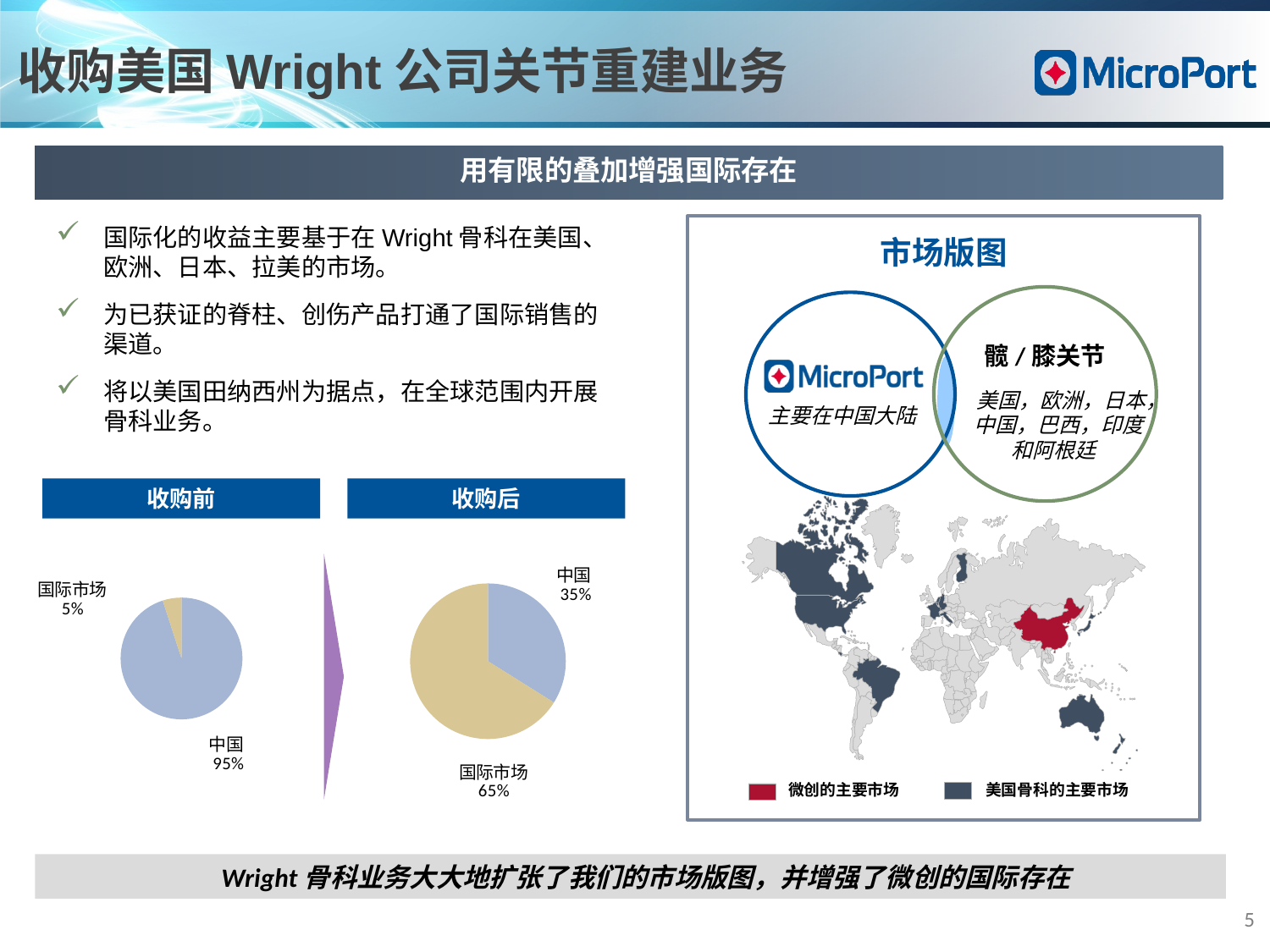
What is the difference between the 国际市场 share in the 收购后 pie chart and the 国际市场 share in the 收购前 pie chart? 60% In the 收购后 pie chart, which slice is the smallest? 中国 In the 收购前 pie chart, what is the difference between the 中国 share and the 国际市场 share? 90% In the 收购后 pie chart, what share does 国际市场 have? 65% What type of chart is used for 收购前 and 收购后? Pie chart How many slices does the 收购后 pie chart have? 2 In the 收购后 pie chart, what share does 中国 have? 35% In the 收购前 pie chart, which slice is the largest? 中国 In the 收购前 pie chart, what share does 中国 have? 95% In the 收购前 pie chart, what share does 国际市场 have? 5% In the 收购后 pie chart, which is larger, 中国 or 国际市场? 国际市场 How many pie charts are shown on the slide? 2